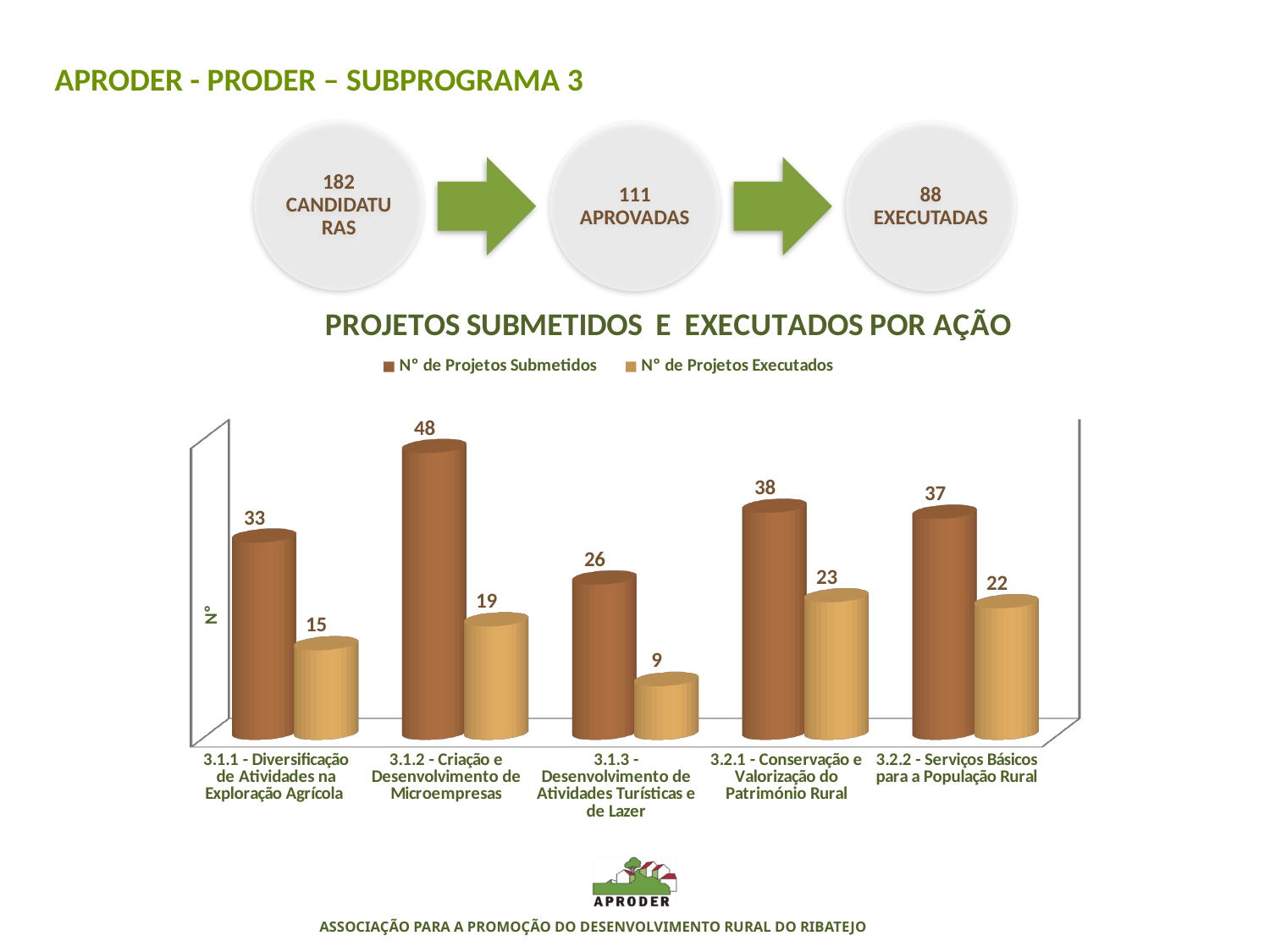
What is the number of Projetos Submetidos for 3.1.2 - Criação e Desenvolvimento de Microempresas? 48 What is the difference between Projetos Submetidos and Projetos Executados for 3.1.1 - Diversificação de Atividades na Exploração Agrícola? 18 What type of chart is shown on the slide? bar chart Which category has the lowest number of Projetos Executados? 3.1.3 - Desenvolvimento de Atividades Turísticas e de Lazer What is the number of Projetos Executados for 3.1.3 - Desenvolvimento de Atividades Turísticas e de Lazer? 9 What is the difference in Projetos Executados between 3.1.2 - Criação e Desenvolvimento de Microempresas and 3.1.1 - Diversificação de Atividades na Exploração Agrícola? 4 How many series does the chart legend list? 2 Which category has the highest number of Projetos Submetidos? 3.1.2 - Criação e Desenvolvimento de Microempresas What is the number of Projetos Executados for 3.2.1 - Conservação e Valorização do Património Rural? 23 What is the title of the chart? PROJETOS SUBMETIDOS E EXECUTADOS POR AÇÃO How many categories (ações) are shown on the x axis of the chart? 5 Which has more Projetos Submetidos: 3.2.1 - Conservação e Valorização do Património Rural or 3.1.3 - Desenvolvimento de Atividades Turísticas e de Lazer? 3.2.1 - Conservação e Valorização do Património Rural